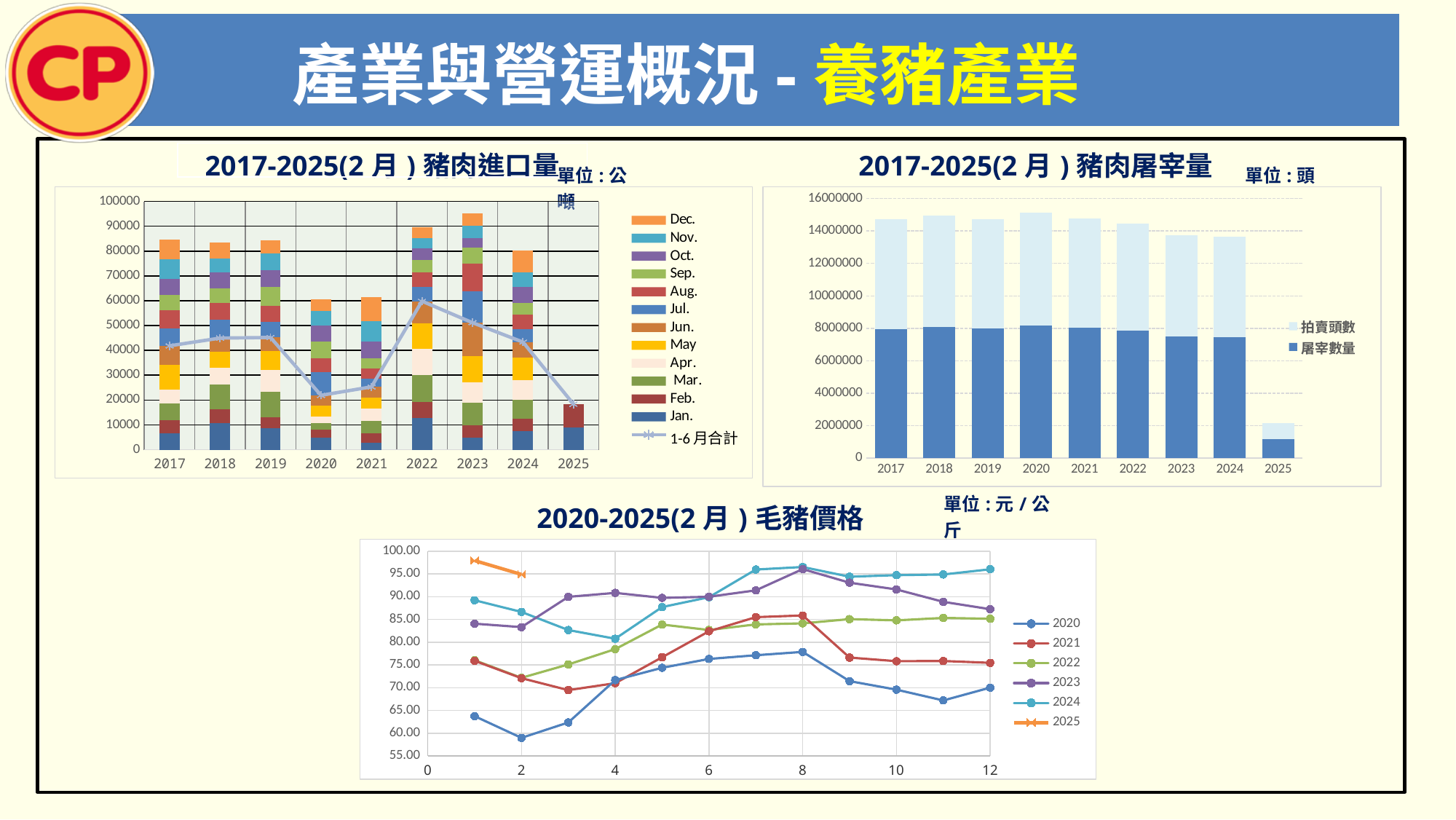
In the 2017-2025(2月) 豬肉屠宰量 chart, is the total bar for 2025 greater or less than 4000000? less In the 2017-2025(2月) 豬肉進口量 chart, which year has the tallest stacked bar? 2023 In the 2020-2025(2月) 毛豬價格 chart, at month 12, which series is higher: 2024 or 2020? 2024 In the 2017-2025(2月) 豬肉進口量 chart, how many years are shown on the x axis? 9 In the 2017-2025(2月) 豬肉屠宰量 chart, which year has the lowest total bar? 2025 In the 2017-2025(2月) 豬肉屠宰量 chart, is the total bar for 2017 greater or less than 14000000? greater In the 2017-2025(2月) 豬肉進口量 chart, how many entries does the legend list? 13 In the 2020-2025(2月) 毛豬價格 chart, how many series does the legend list? 6 In the 2017-2025(2月) 豬肉屠宰量 chart, how many series does the legend list? 2 In the 2017-2025(2月) 豬肉進口量 chart, is the total stacked bar for 2020 greater or less than 70000? less What kind of chart is the 2017-2025(2月) 豬肉進口量 chart? stacked bar chart with a line What kind of chart is the 2020-2025(2月) 毛豬價格 chart? line chart